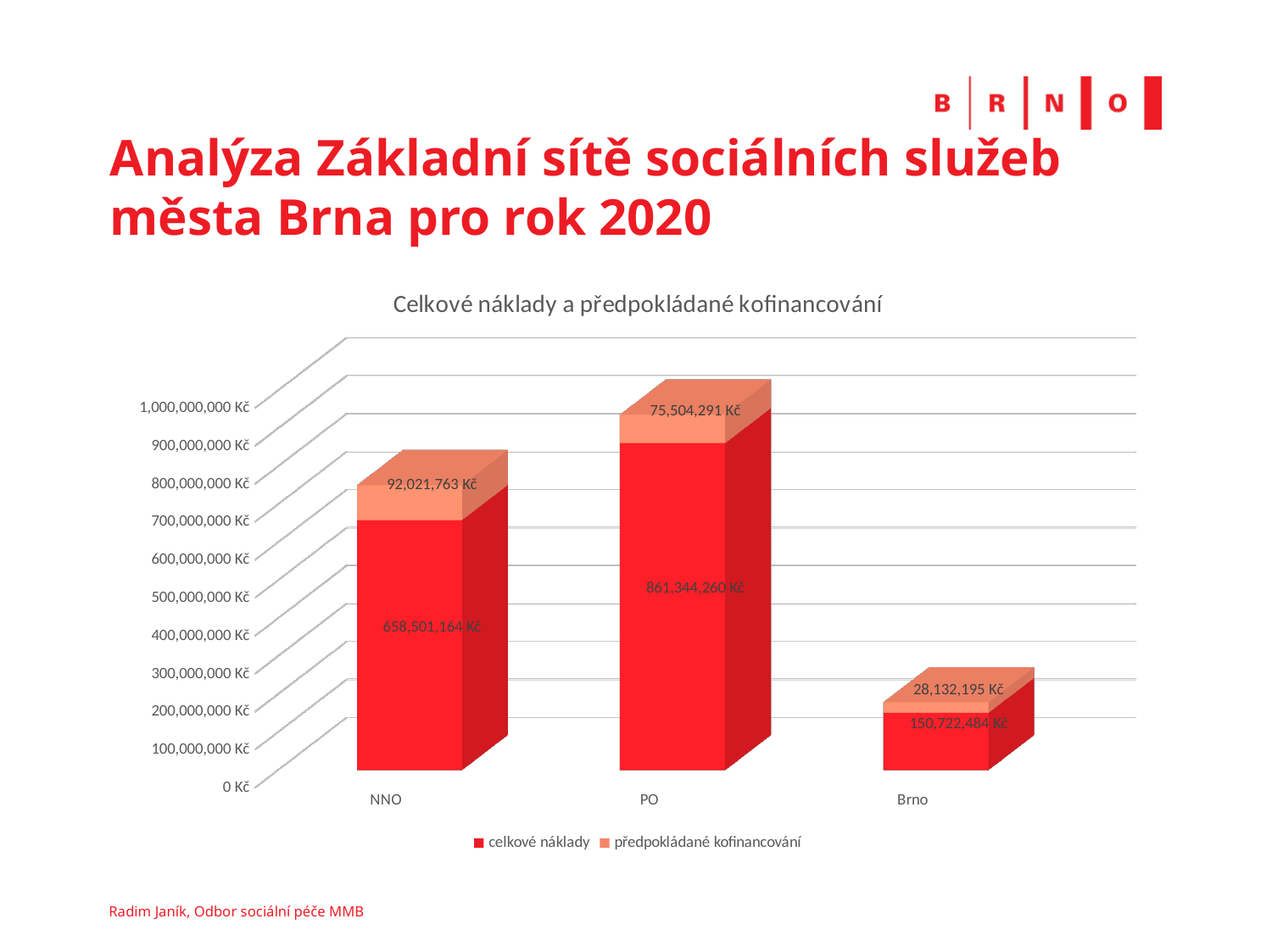
Which category has the lowest předpokládané kofinancování? Brno What is the value of celkové náklady for PO? 861,344,260 Kč What is the difference in celkové náklady between PO and NNO? 202,843,096 Kč What type of chart is shown on the slide? stacked bar chart What is the title of the chart? Celkové náklady a předpokládané kofinancování How many series does the chart legend list? 2 Which is larger, the předpokládané kofinancování for NNO or for PO? NNO What is the value of předpokládané kofinancování for NNO? 92,021,763 Kč Which category has the highest celkové náklady? PO What is the value of celkové náklady for Brno? 150,722,484 Kč What is the total of the stacked bar for Brno? 178,854,679 Kč How many categories are shown on the x axis of the chart? 3